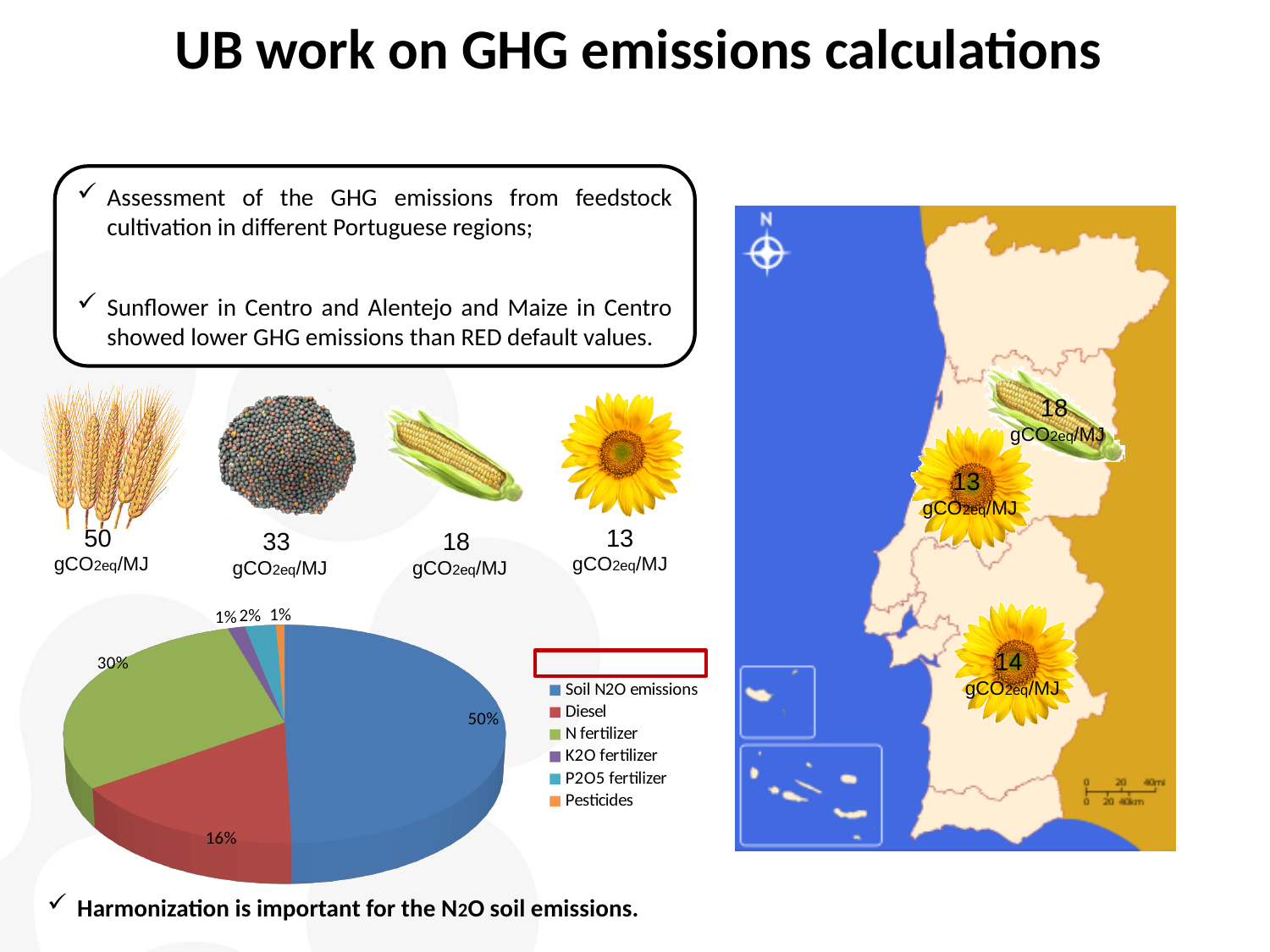
What share of the pie chart is Soil N2O emissions? 50% What is the value shown for N fertilizer in the pie chart? 30% Which category has the largest slice in the pie chart? Soil N2O emissions In the pie chart, which is larger, N fertilizer or Diesel? N fertilizer What kind of chart is shown at the bottom left of the slide? pie chart What is the value shown for Diesel in the pie chart? 16% What do the Soil N2O emissions, N fertilizer and Diesel slices add up to in the pie chart? 96% How many slices in the pie chart are labelled 1%? 2 What colour is the Soil N2O emissions slice in the pie chart? blue What is the difference in percentage points between Soil N2O emissions and Diesel in the pie chart? 34 What is the difference in percentage points between N fertilizer and Diesel in the pie chart? 14 How many categories does the legend of the pie chart list? 6